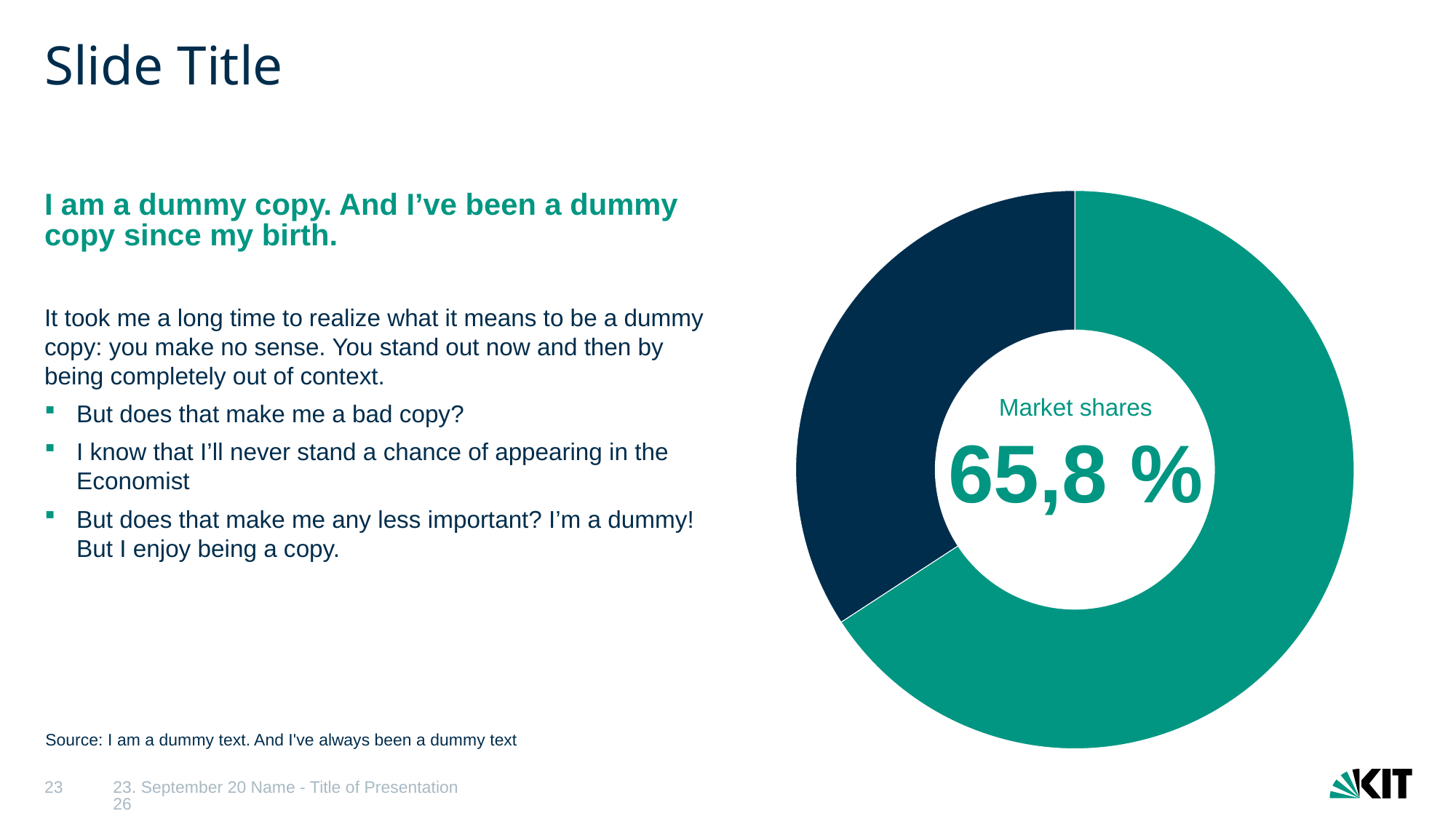
How many slices does the pie chart have? 2 What share of the pie does the teal (green) slice represent? 65,8 % What percentage is printed in the centre of the pie chart? 65,8 % What label is printed in the centre of the pie chart above the percentage? Market shares Which slice of the pie chart is the largest? The teal slice Which slice of the pie chart is larger, the teal one or the dark navy one? The teal one What two colours are used for the slices of the pie chart? Teal and dark navy Which slice of the pie chart is the smallest? The dark navy slice What kind of chart is shown on the slide? Pie chart (donut)